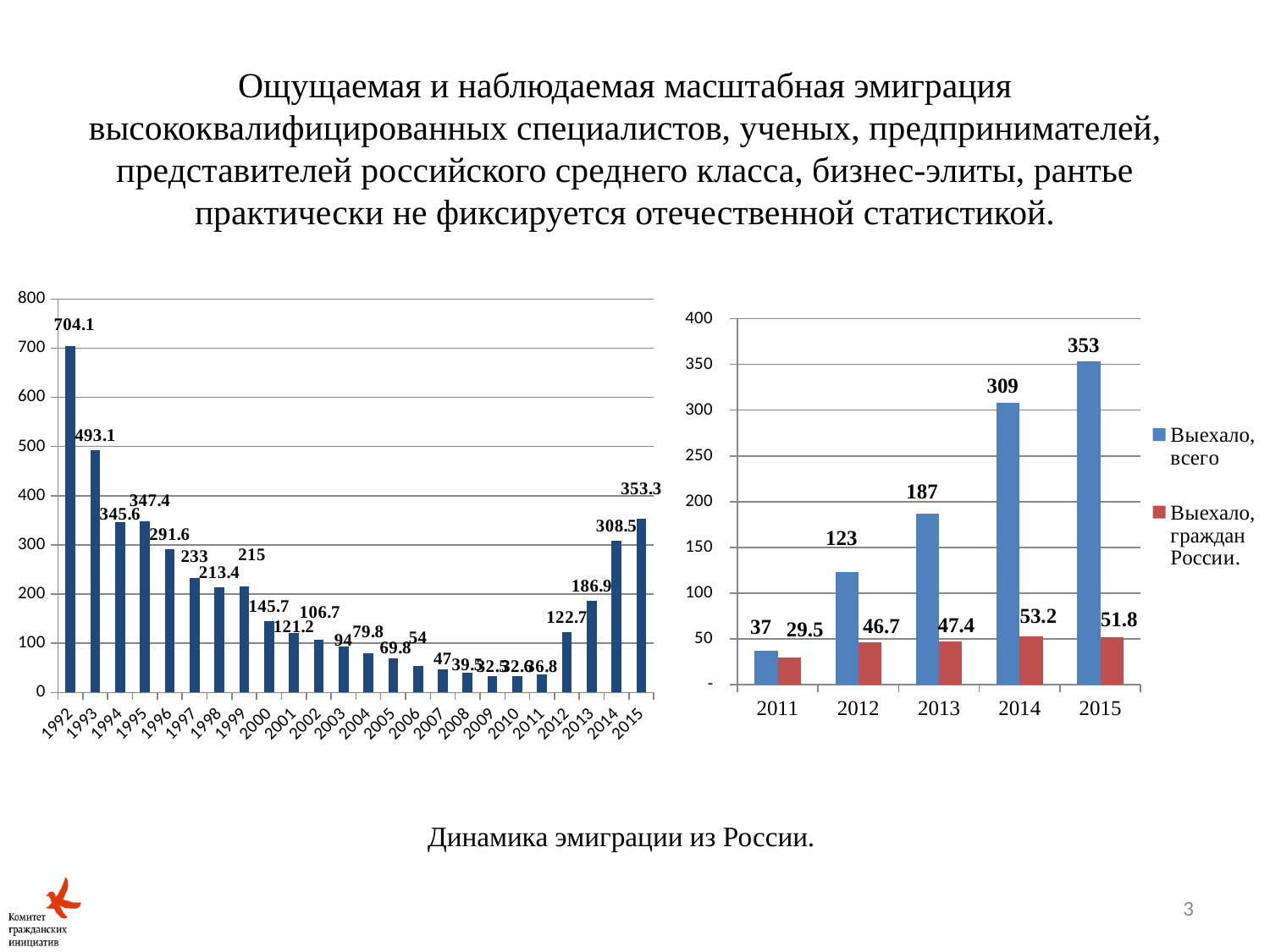
In the right chart, what is the value of 'Выехало, граждан России.' for 2014? 53.2 In the left chart, what is the difference between the values for 2015 and 2013? 166.4 In the left chart, what is the value for 2014? 308.5 In the left chart, which year has the highest value? 1992 In the left chart, how many years are shown on the x axis? 24 What kind of chart is the right chart? bar chart In the left chart, what is the value for 1992? 704.1 In the right chart, what is the value of 'Выехало, всего' for 2013? 187 In the left chart, do the values rise or fall from 2011 to 2015? rise In the right chart, which year has the lowest value of 'Выехало, всего'? 2011 In the left chart, which is larger, the value for 1994 or the value for 1996? 1994 In the right chart, how many series does the legend list? 2